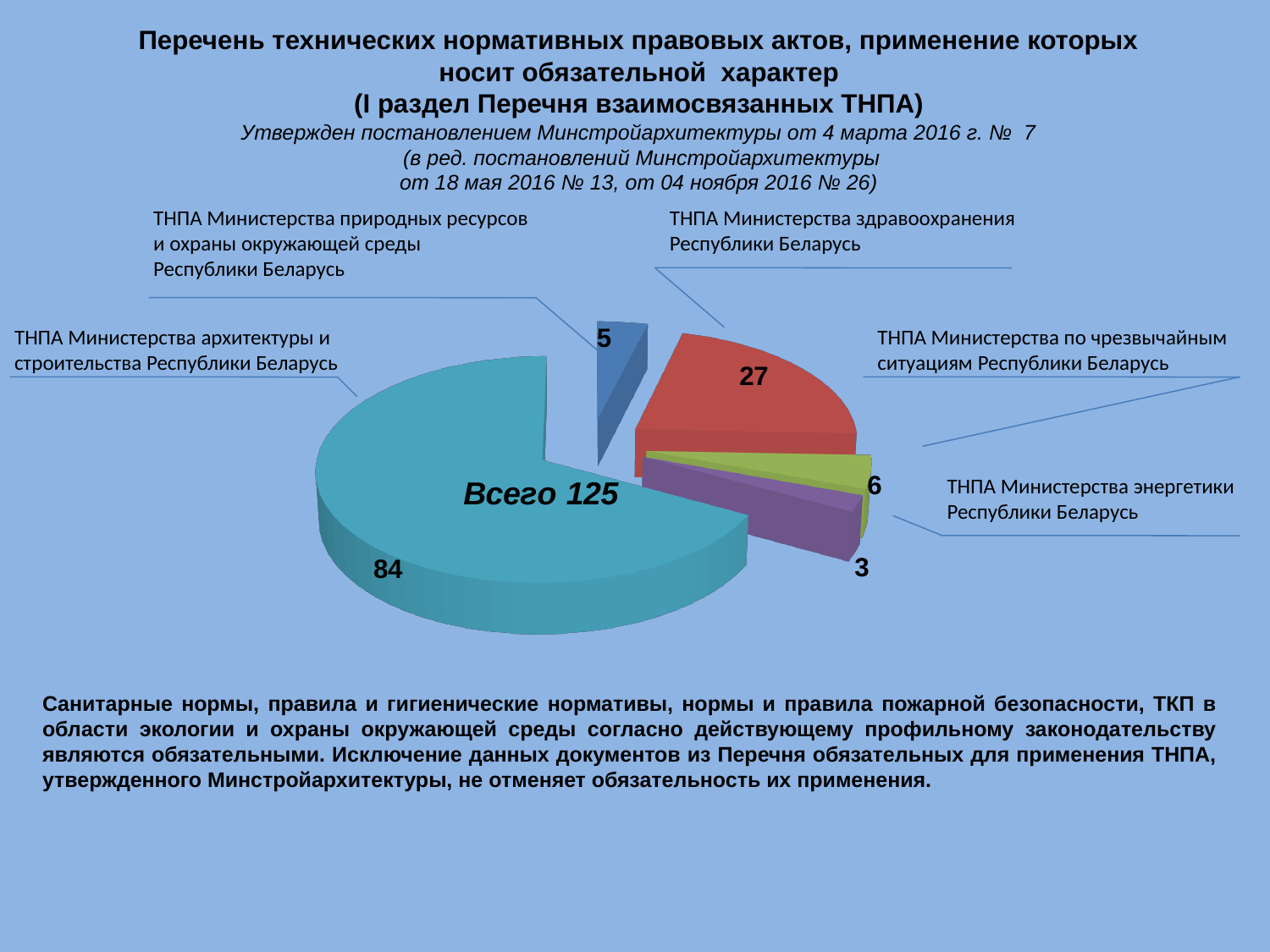
What type of chart is shown on the slide? pie chart What is the value for ТНПА Министерства природных ресурсов и охраны окружающей среды Республики Беларусь? 5 What total is printed in the centre of the pie chart? Всего 125 Which category has the smallest slice of the pie? ТНПА Министерства энергетики Республики Беларусь What share of the total of 125 does the slice for ТНПА Министерства здравоохранения (27) represent? 21.6% What is the value for ТНПА Министерства энергетики Республики Беларусь? 3 Which category has the largest slice of the pie? ТНПА Министерства архитектуры и строительства Республики Беларусь What is the difference between the values for ТНПА Министерства архитектуры и строительства and ТНПА Министерства здравоохранения? 57 What is the value for ТНПА Министерства архитектуры и строительства Республики Беларусь? 84 Which is larger: the value for ТНПА Министерства по чрезвычайным ситуациям or the value for ТНПА Министерства природных ресурсов? ТНПА Министерства по чрезвычайным ситуациям What is the value for ТНПА Министерства здравоохранения Республики Беларусь? 27 How many slices does the pie chart have? 5